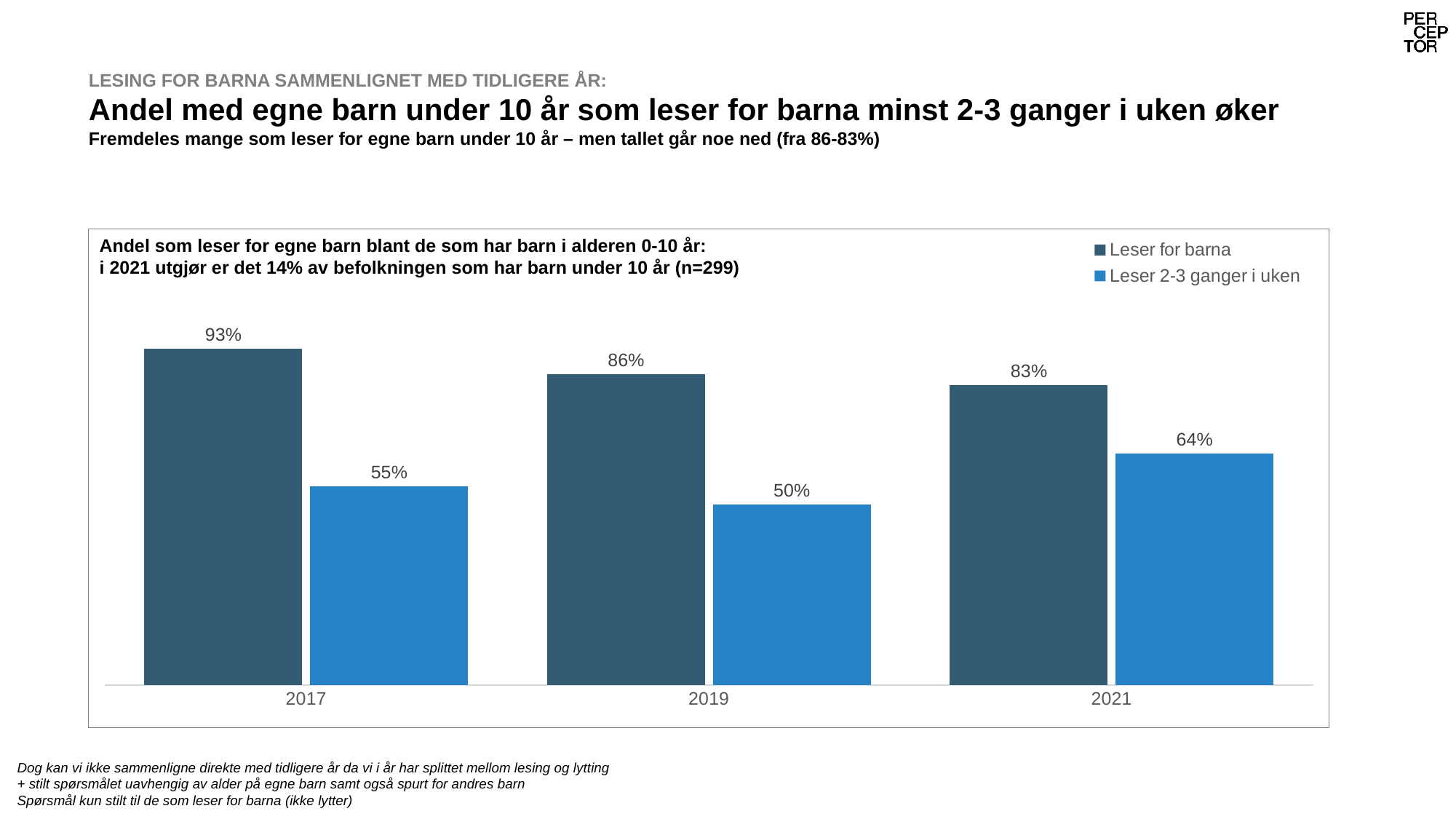
By how much did 'Leser for barna' fall from 2017 to 2021? 10 percentage points How many years are shown on the x axis? 3 What is the value for 'Leser 2-3 ganger i uken' in 2021? 64% How many series does the legend list? 2 What is the value for 'Leser for barna' in 2017? 93% In which year is 'Leser for barna' highest? 2017 In which year is 'Leser 2-3 ganger i uken' lowest? 2019 What is the difference between 'Leser for barna' and 'Leser 2-3 ganger i uken' in 2021? 19 percentage points What is the value for 'Leser 2-3 ganger i uken' in 2019? 50% Which is larger: 'Leser 2-3 ganger i uken' in 2017 or in 2021? 2021 Does 'Leser for barna' rise or fall from 2017 to 2021? Fall What kind of chart is shown on the slide? Bar chart